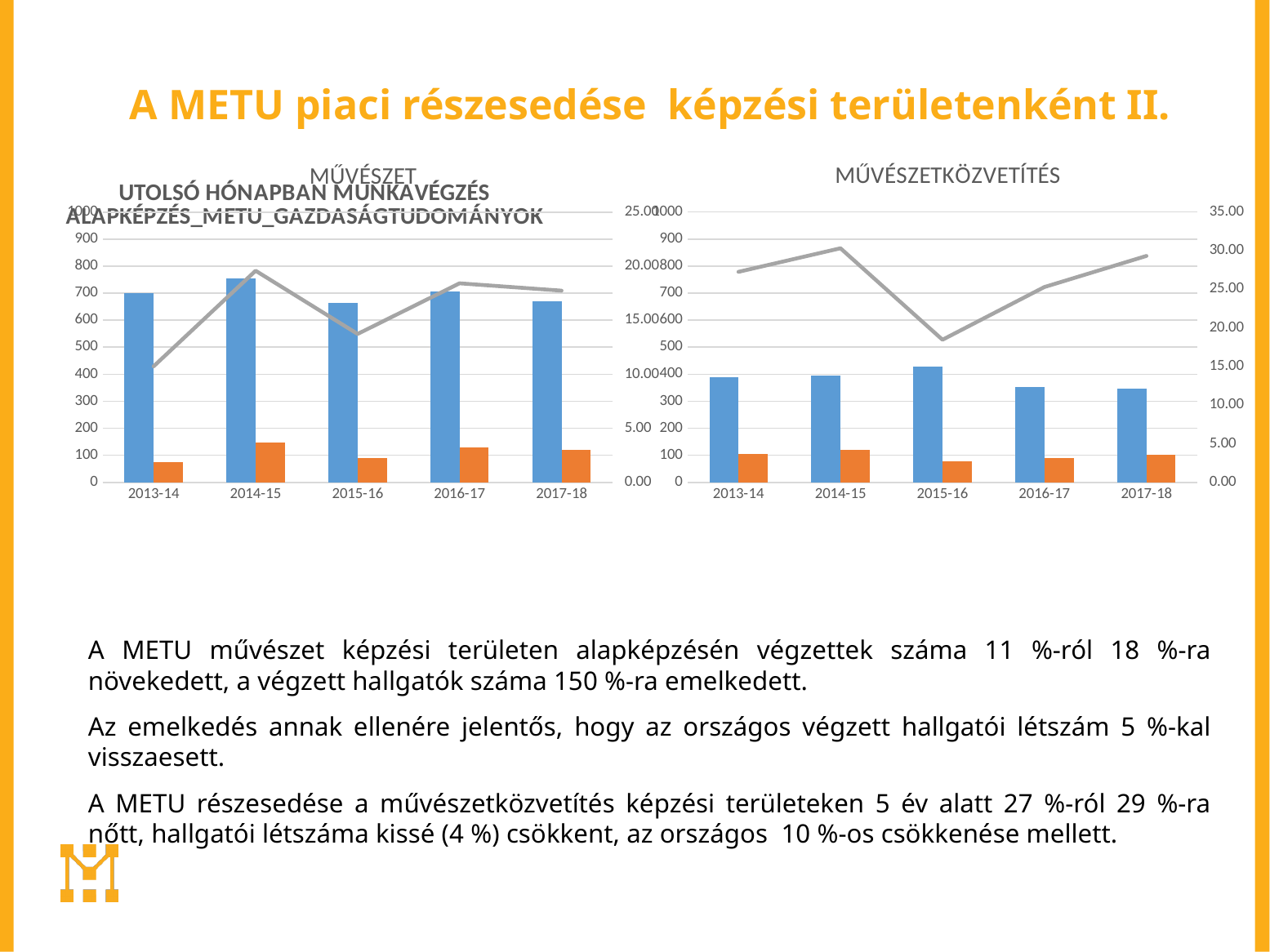
In the right (MŰVÉSZETKÖZVETÍTÉS) chart, which year has the tallest blue bar? 2015-16 In the left (MŰVÉSZET) chart, which is larger: the blue bar for 2014-15 or the blue bar for 2015-16? 2014-15 In the left (MŰVÉSZET) chart, is the blue bar for 2014-15 greater or less than 700? greater What is the title of the chart on the right side of the slide? MŰVÉSZETKÖZVETÍTÉS In the right (MŰVÉSZETKÖZVETÍTÉS) chart, in which year does the grey line reach its lowest point? 2015-16 How many year categories are shown on the x axis of the MŰVÉSZETKÖZVETÍTÉS chart? 5 In the left (MŰVÉSZET) chart, which year has the shortest orange bar? 2013-14 What kind of chart is the MŰVÉSZETKÖZVETÍTÉS chart on the right? Bar chart with a line In the left (MŰVÉSZET) chart, which year has the tallest blue bar? 2014-15 In the right (MŰVÉSZETKÖZVETÍTÉS) chart, is the blue bar for 2015-16 greater or less than 400? greater In the left (MŰVÉSZET) chart, is the orange bar for 2013-14 greater or less than 100? less